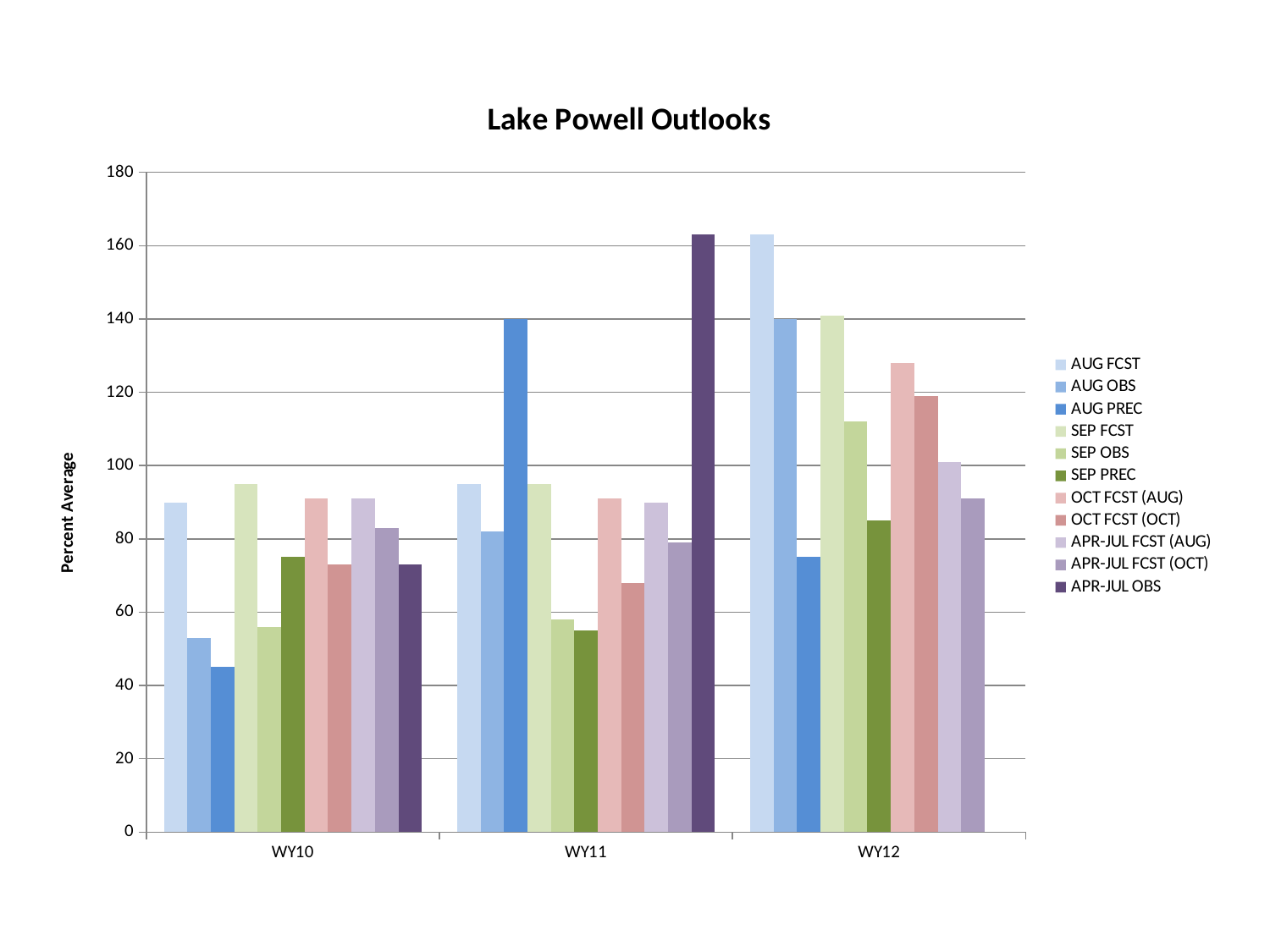
What is the title of the chart? Lake Powell Outlooks In WY11, which is larger: AUG PREC or AUG OBS? AUG PREC Which category has the lowest AUG OBS value? WY10 Is the value for AUG FCST in WY12 greater or less than 140? greater Does the AUG FCST value rise or fall from WY10 to WY12? rise What is the label of the y axis? Percent Average Is the value for AUG PREC in WY10 greater or less than 60? less What kind of chart is shown on the slide? bar chart Which category has the highest AUG FCST value? WY12 Is the value for APR-JUL OBS in WY11 greater or less than 140? greater How many series does the legend list? 11 How many categories are shown on the x axis? 3